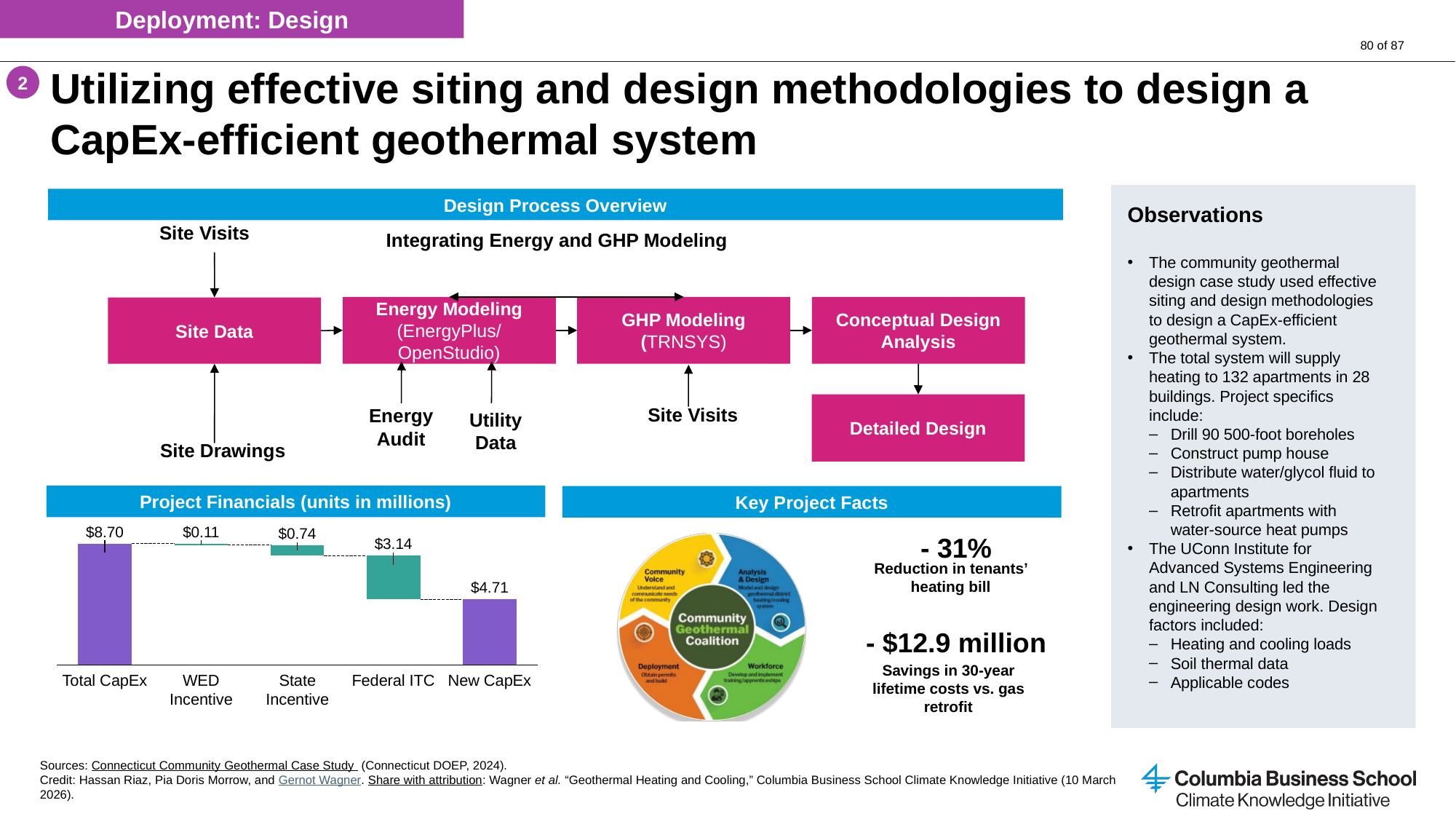
In the Project Financials chart, what is the value for the Federal ITC? $3.14 What units does the Project Financials chart title say the values are in? Millions In the Project Financials chart, which category has the lowest value? WED Incentive How many categories are shown in the Project Financials chart? 5 What kind of chart is the Project Financials chart? Bar chart (waterfall) In the Project Financials chart, what is the value for the WED Incentive? $0.11 In the Project Financials chart, what is the value for the State Incentive? $0.74 In the Project Financials chart, which is larger, the Federal ITC or the State Incentive? Federal ITC In the Project Financials chart, which category has the highest value? Total CapEx In the Project Financials chart, what is the value for Total CapEx? $8.70 In the Project Financials chart, what is the value for New CapEx? $4.71 In the Project Financials chart, what is the difference between Total CapEx and New CapEx? $3.99